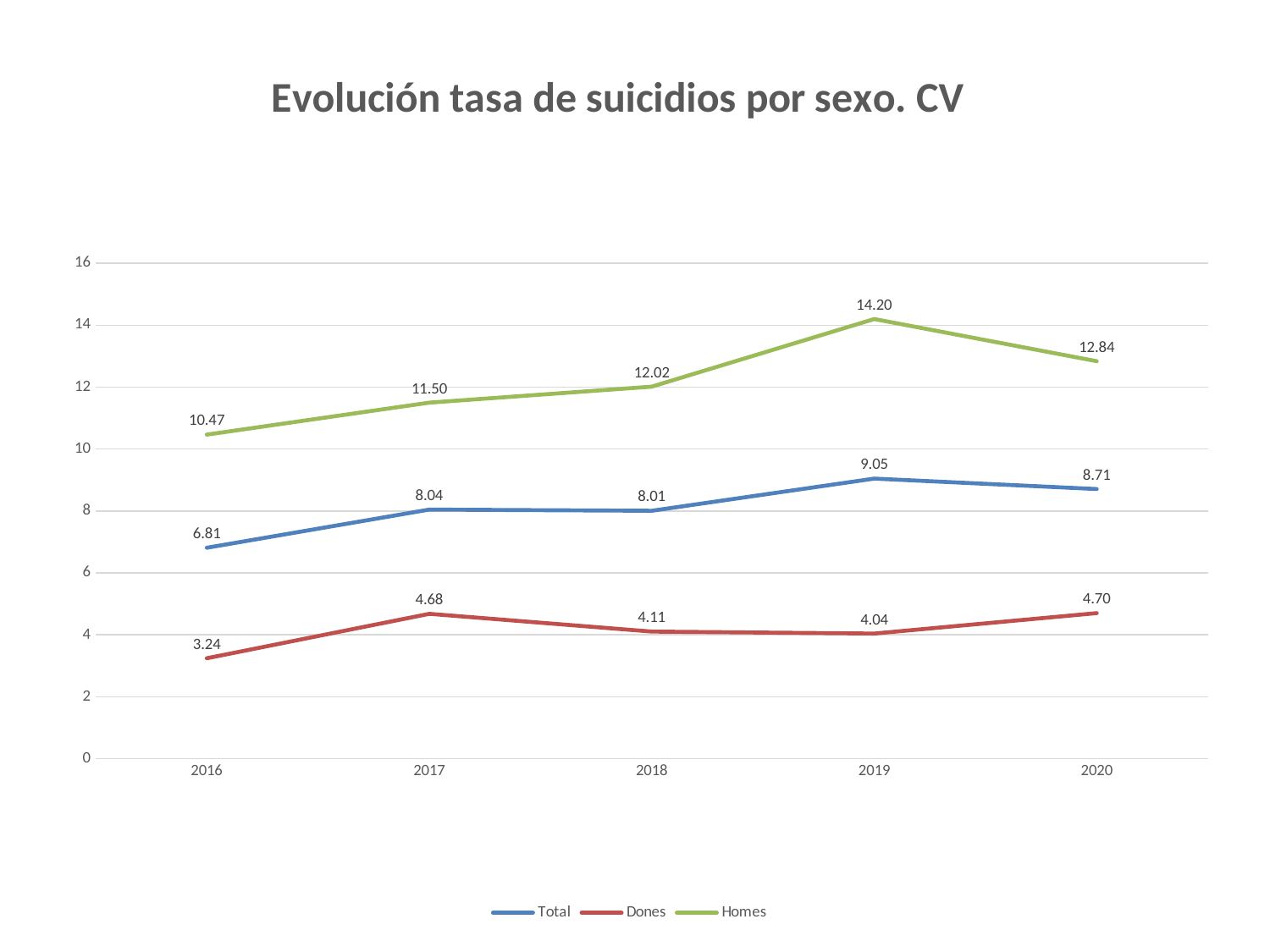
What is the value for Total in 2020? 8.71 Which is larger, the Dones value in 2017 or the Dones value in 2018? 2017 In which year is the Homes series highest? 2019 How many series does the legend list? 3 In which year is the Dones series lowest? 2016 What is the value for Dones in 2016? 3.24 How many years are shown on the x axis? 5 What is the value for Homes in 2019? 14.20 Does the Total series rise or fall from 2016 to 2019? Rise What kind of chart is shown on the slide? Line chart What is the difference between the Homes and Dones values in 2020? 8.14 What is the title of the chart? Evolución tasa de suicidios por sexo. CV